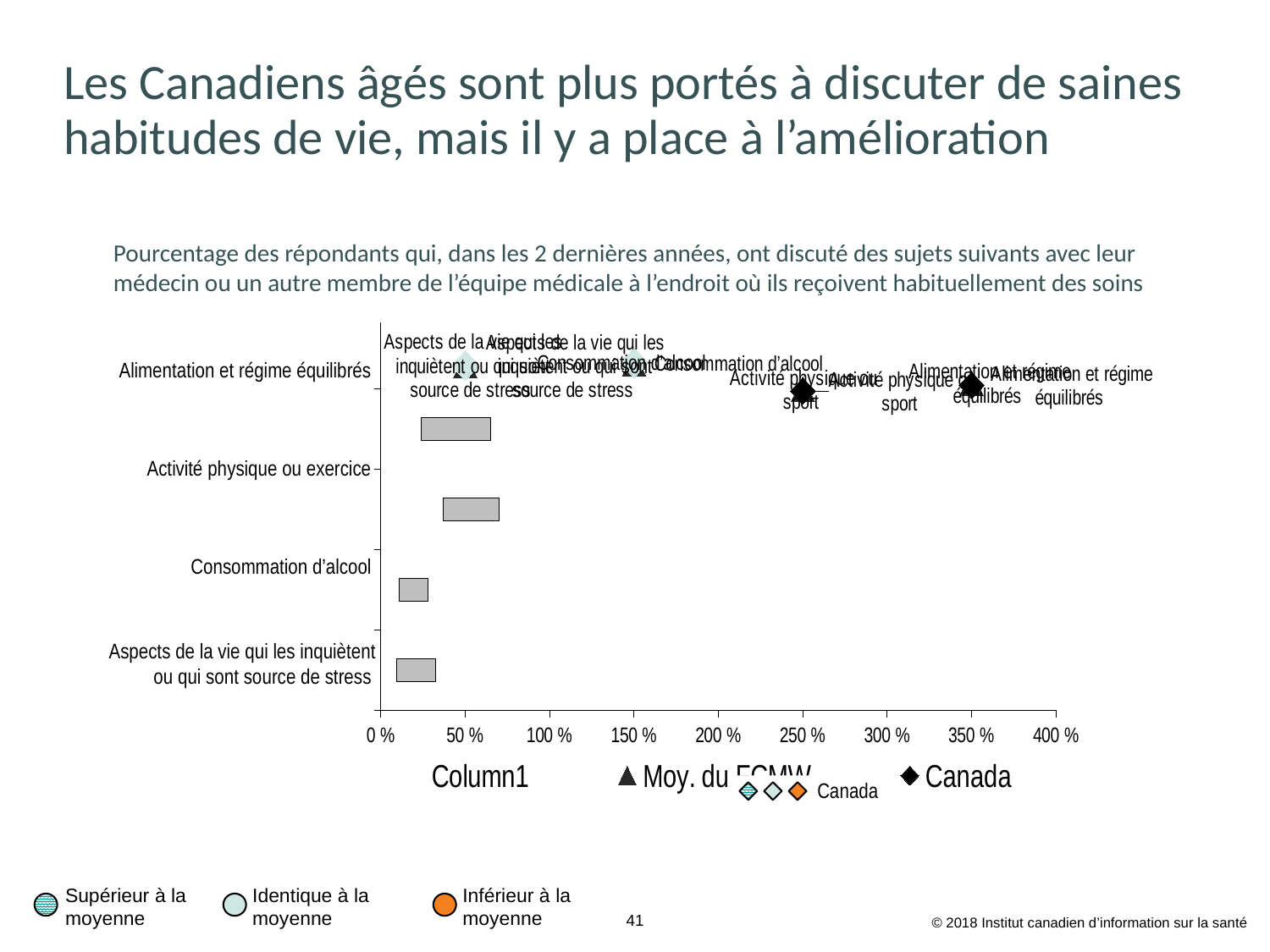
Is the Canada marker for Alimentation et régime équilibrés greater or less than 300 %? greater Which category appears at the bottom of the vertical axis of the chart? Aspects de la vie qui les inquiètent ou qui sont source de stress Is the Canada marker for Activité physique ou sport greater or less than 300 %? less Which is larger, the Canada marker for Alimentation et régime équilibrés or the Canada marker for Activité physique ou sport? Alimentation et régime équilibrés What kind of chart is shown on the slide? bar chart How many series does the chart legend list? 3 Is the Canada marker for Activité physique ou sport greater or less than 200 %? greater How many categories are listed on the vertical axis of the chart? 4 What is the highest value shown on the horizontal axis of the chart? 400 % How many tick labels are shown on the horizontal axis of the chart? 9